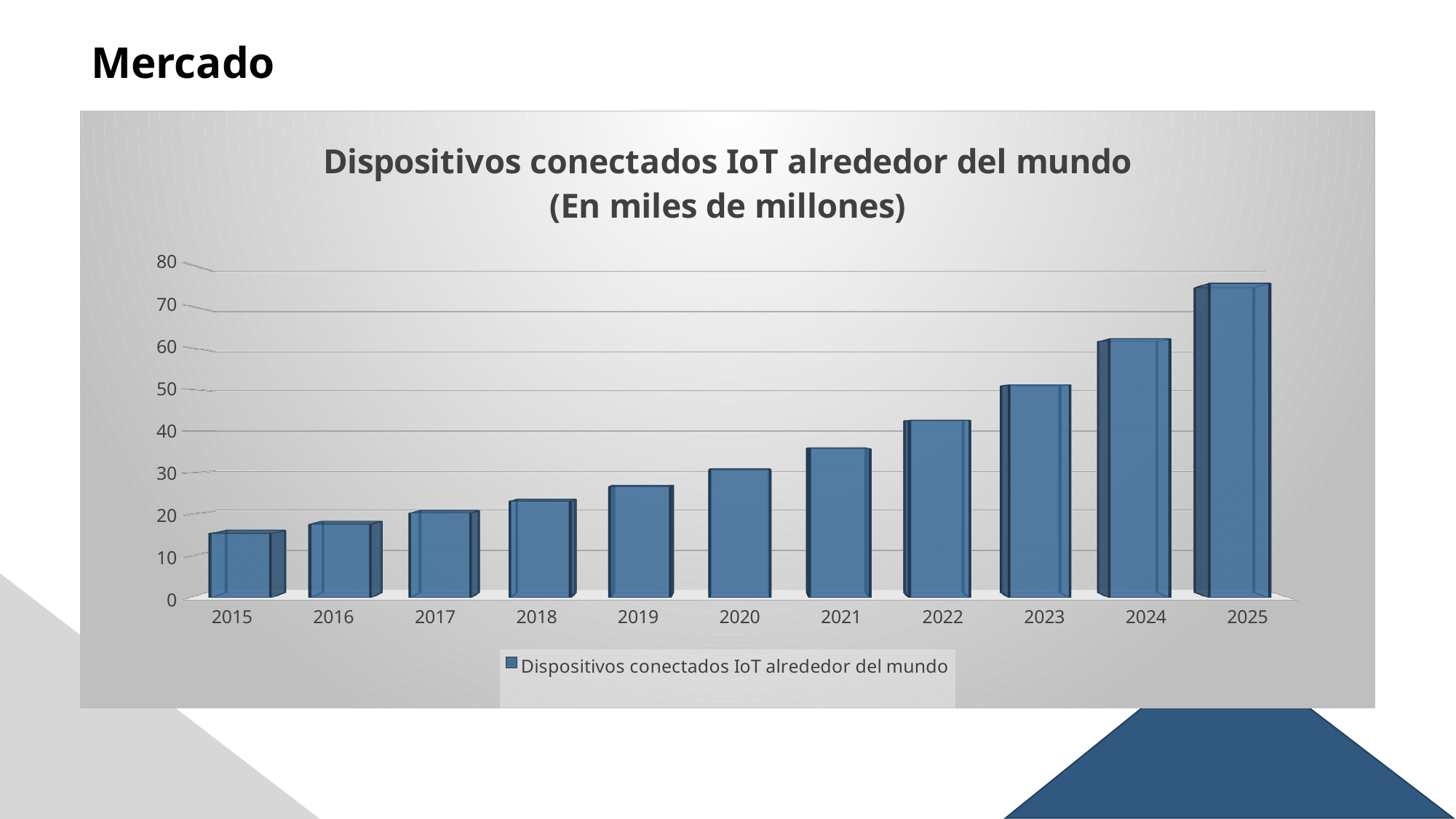
What kind of chart is shown on the slide? bar chart How many series does the legend list? 1 Is the value for 2022 greater or less than 50? less How many years are shown on the x axis of the chart? 11 Which year has the lowest number of connected IoT devices? 2015 Do the values rise or fall from 2015 to 2025? rise Which year has the highest number of connected IoT devices? 2025 Is the value for 2023 greater or less than 40? greater Which year has the larger value, 2018 or 2024? 2024 Is the value for 2015 greater or less than 20? less What is the title of the chart? Dispositivos conectados IoT alrededor del mundo (En miles de millones)